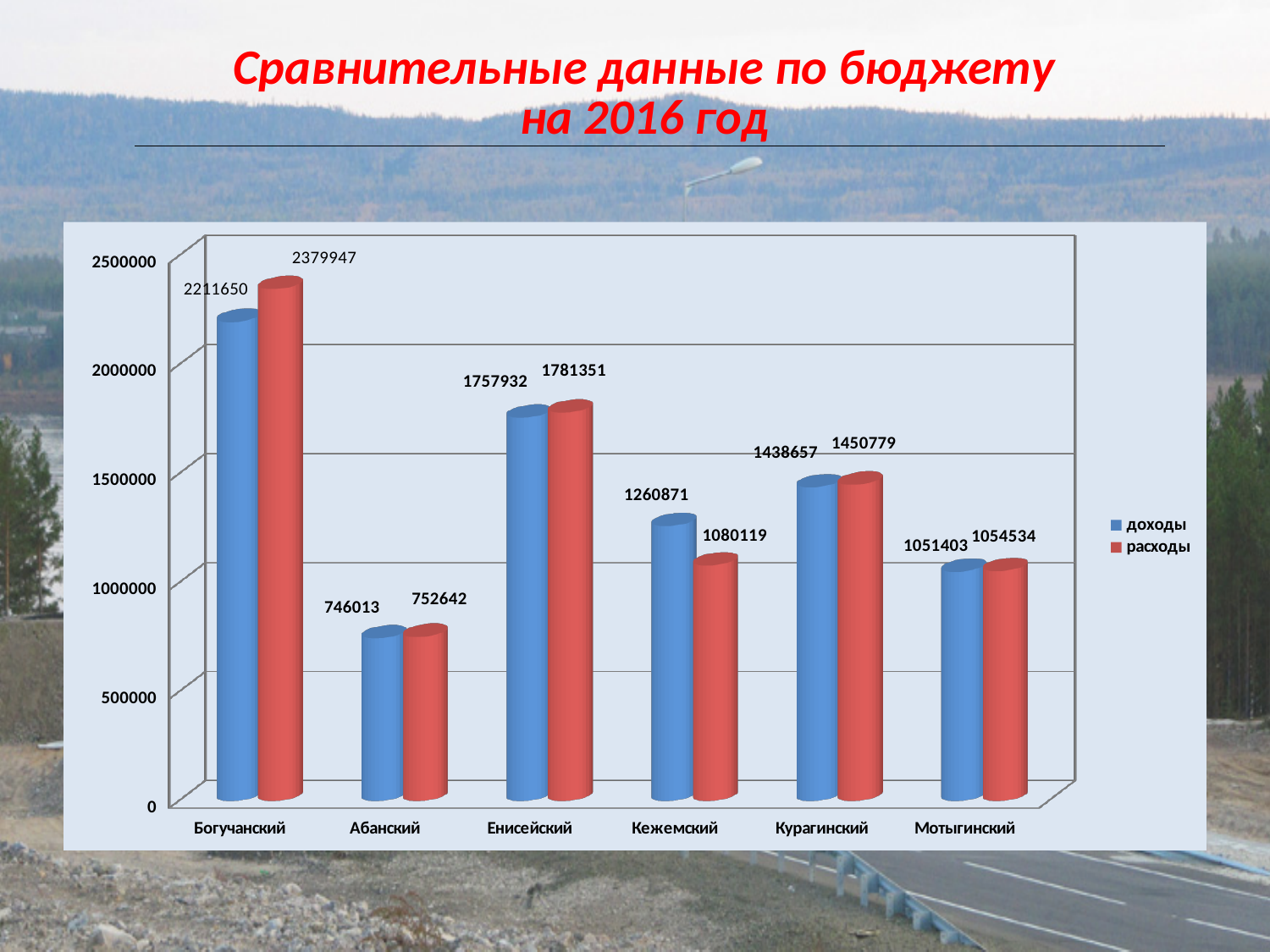
What kind of chart is shown on the slide? bar chart What is the difference between доходы and расходы for Кежемский? 180752 Which category has the highest расходы value? Богучанский What is the difference between расходы and доходы for Богучанский? 168297 What is the value of расходы for Кежемский? 1080119 Which is larger for Кежемский: доходы or расходы? доходы Which category has the lowest доходы value? Абанский How many categories are shown on the x axis? 6 What is the value of доходы for Богучанский? 2211650 How many series does the legend list? 2 What is the value of расходы for Абанский? 752642 Is the доходы value for Енисейский greater or less than 1500000? greater